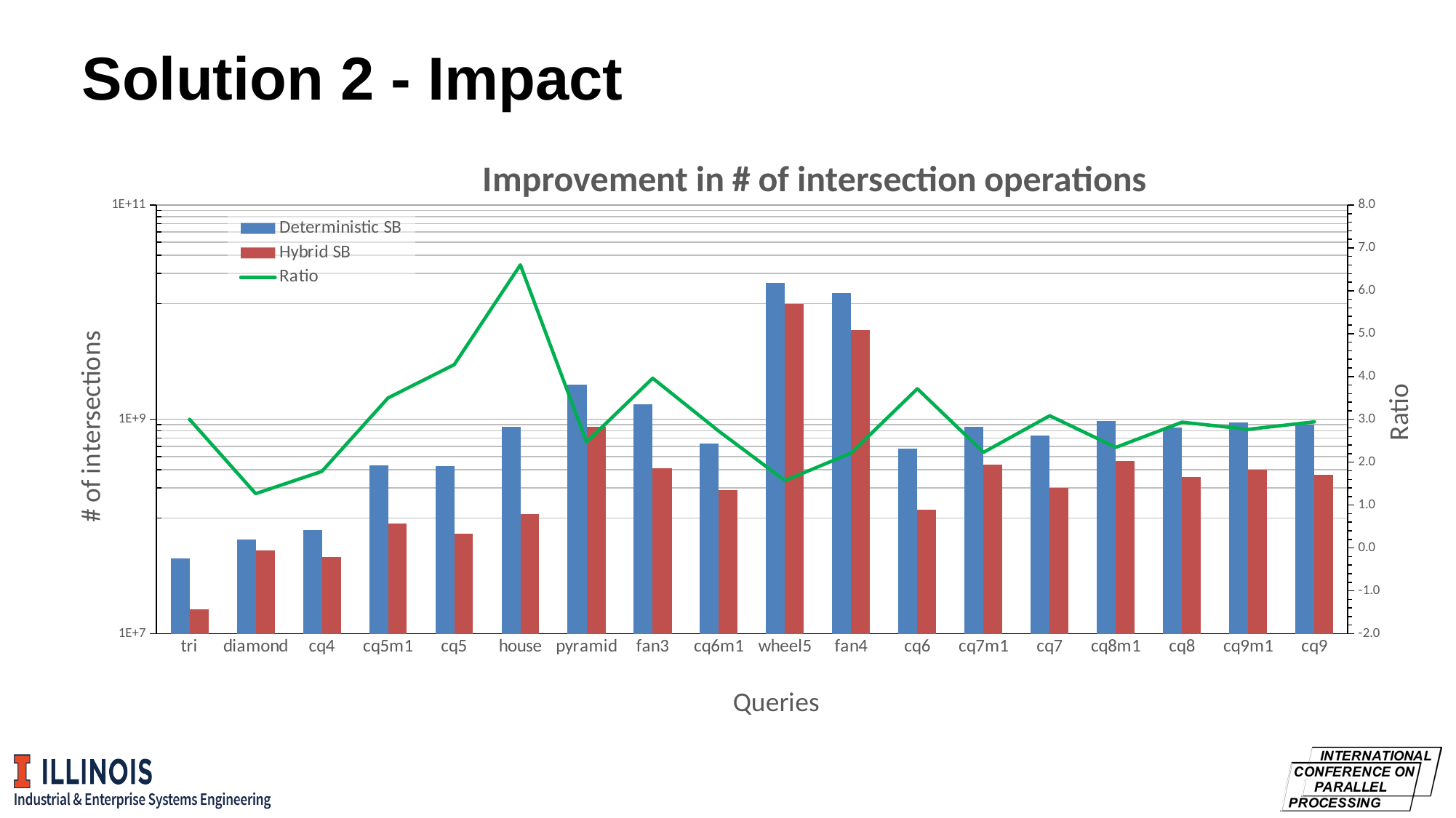
Which is larger, the Deterministic SB value for wheel5 or for fan4? wheel5 Which query has the highest Ratio value? house Is the Deterministic SB value for wheel5 greater or less than 1E+9? greater What label is on the right-hand vertical axis of the chart? Ratio Which query has the highest Deterministic SB value? wheel5 Is the Ratio value for house greater or less than 6.0? greater What is the title of the chart? Improvement in # of intersection operations Is the Hybrid SB value for house greater or less than 1E+9? less How many series does the chart legend list? 3 Which query has the lowest Hybrid SB value? tri How many queries are shown along the x axis of the chart? 18 What kind of chart is shown on the slide? Bar chart with a line series